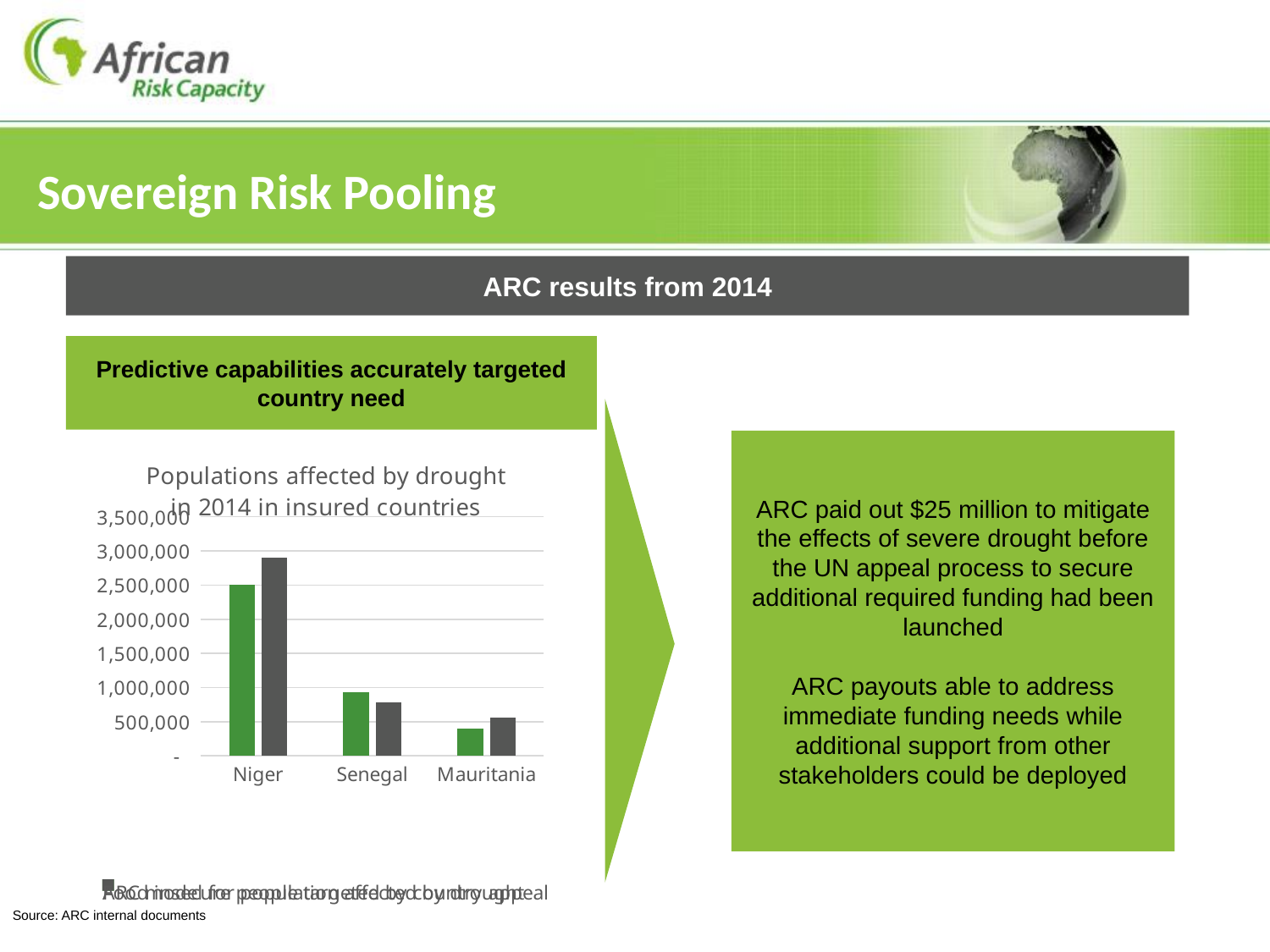
Which country has the lowest grey bar in the chart? Mauritania For Senegal, which bar is larger, the green bar or the grey bar? the green bar Is the green bar for Senegal greater or less than 1,000,000? less Is the grey bar for Mauritania greater or less than 1,000,000? less What is the title of the chart? Populations affected by drought in 2014 in insured countries Which country has the highest green bar in the chart? Niger How many countries are shown on the x axis of the chart? 3 What kind of chart is shown on the slide? bar chart Is the green bar for Mauritania greater or less than 500,000? less For Niger, which bar is larger, the green bar or the grey bar? the grey bar